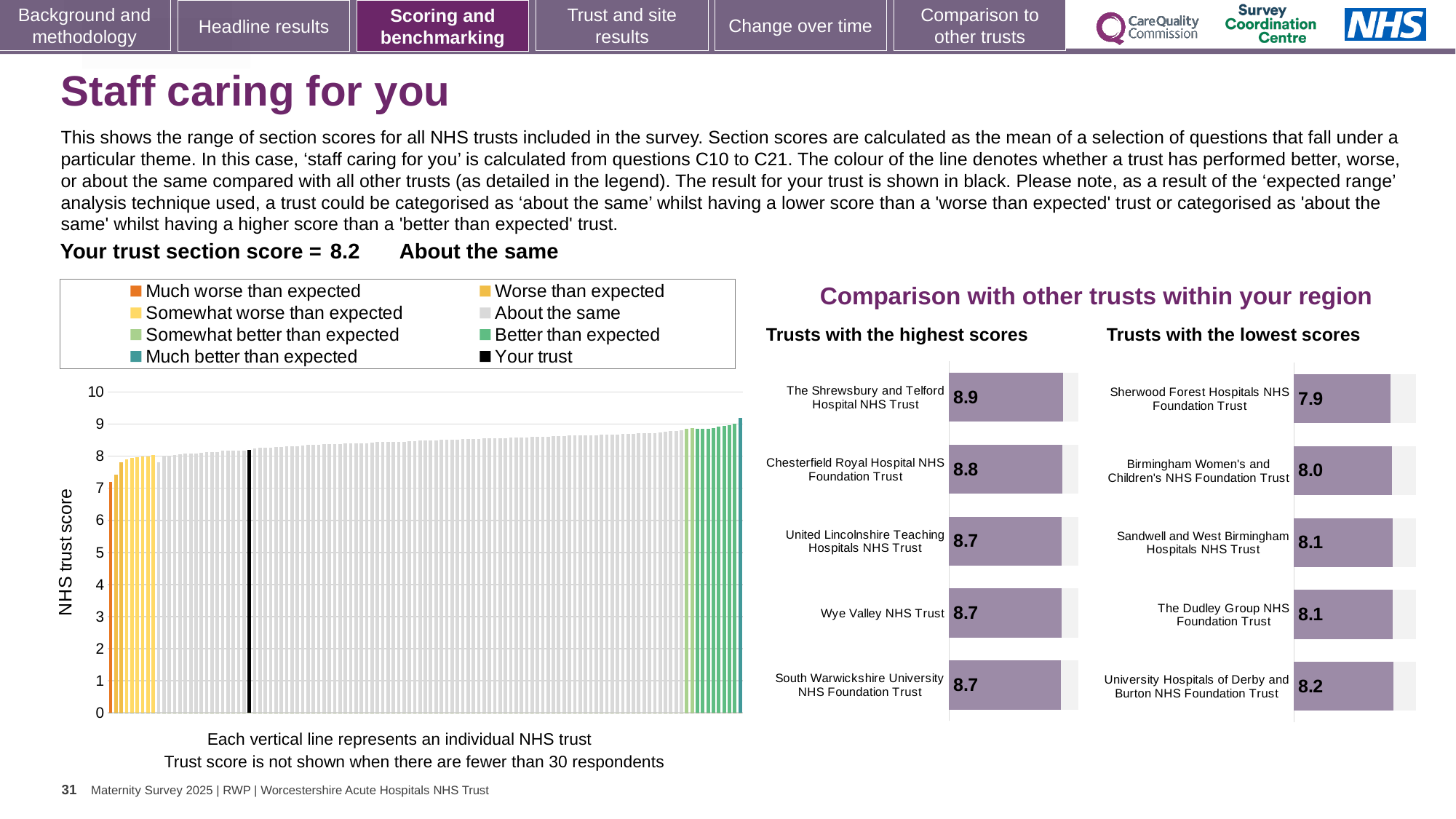
In the 'Trusts with the highest scores' chart, which trust has the highest score? The Shrewsbury and Telford Hospital NHS Trust What kind of chart is the large chart on the left showing NHS trust scores? Bar chart In the 'Trusts with the highest scores' chart, what is the score for The Shrewsbury and Telford Hospital NHS Trust? 8.9 How many trusts are listed in the 'Trusts with the lowest scores' chart? 5 What is the y-axis label of the left-hand chart? NHS trust score In the 'Trusts with the lowest scores' chart, what is the score for Sandwell and West Birmingham Hospitals NHS Trust? 8.1 In the 'Trusts with the lowest scores' chart, what is the score for Sherwood Forest Hospitals NHS Foundation Trust? 7.9 How many entries does the legend of the left-hand chart list? 8 In the left-hand chart, is the value of the lowest (orange) bar greater or less than 8? less In the 'Trusts with the highest scores' chart, what is the difference between the scores of The Shrewsbury and Telford Hospital NHS Trust and Wye Valley NHS Trust? 0.2 In the 'Trusts with the lowest scores' chart, which has the larger score: Birmingham Women's and Children's NHS Foundation Trust or University Hospitals of Derby and Burton NHS Foundation Trust? University Hospitals of Derby and Burton NHS Foundation Trust In the 'Trusts with the lowest scores' chart, which trust has the lowest score? Sherwood Forest Hospitals NHS Foundation Trust